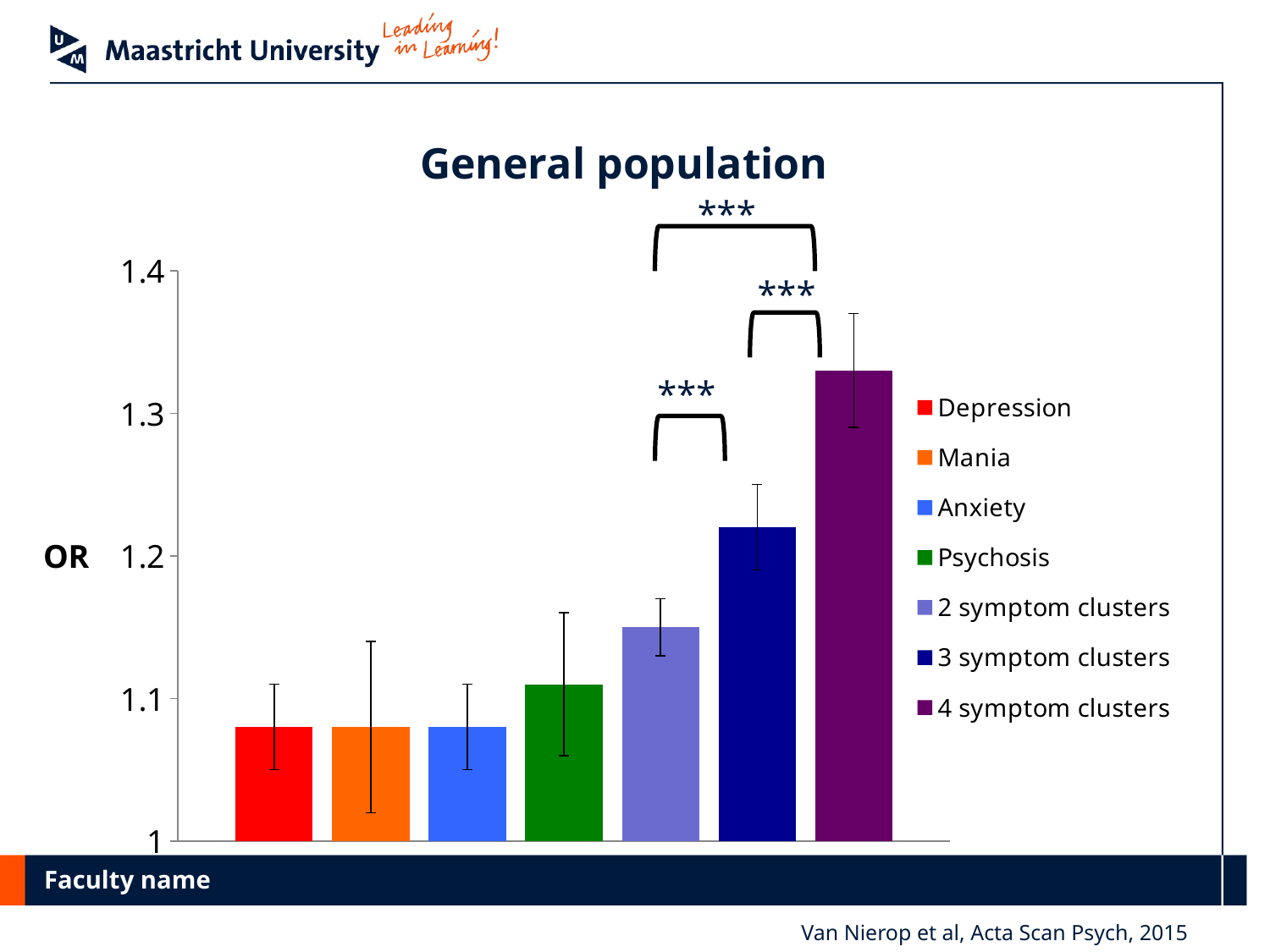
What is the title of the chart? General population Which is larger, the value for 3 symptom clusters or the value for Psychosis? 3 symptom clusters Which series has the highest OR value? 4 symptom clusters Is the value for 2 symptom clusters greater or less than 1.2? less Is the value for 3 symptom clusters greater or less than 1.2? greater Is the value for 4 symptom clusters greater or less than 1.3? greater Do the bar values generally rise or fall from left to right across the chart? rise What label is shown on the y axis of the chart? OR What kind of chart is shown on the slide? bar chart How many bars are plotted in the chart? 7 How many series does the legend list? 7